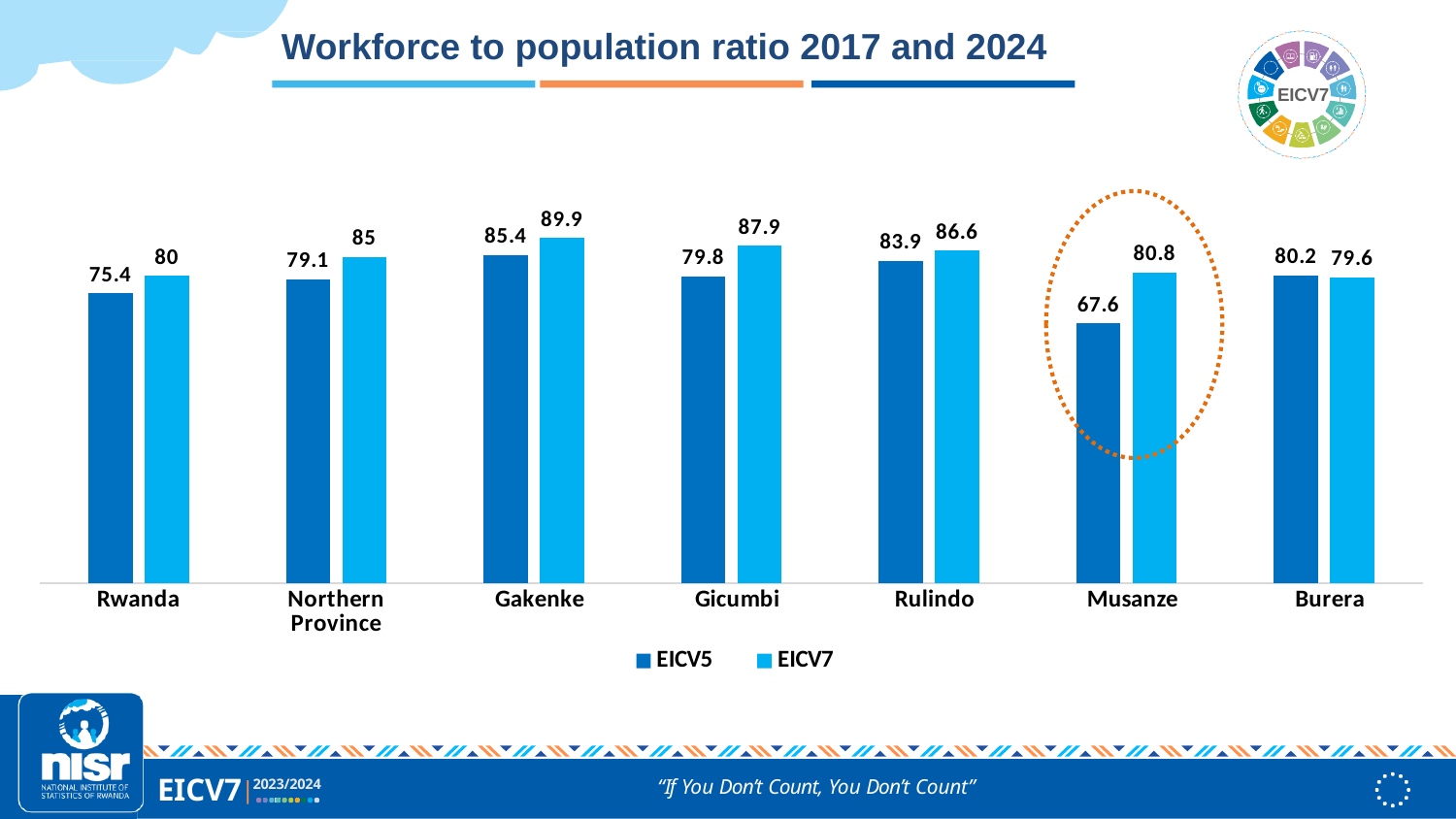
What is the difference between the EICV7 and EICV5 values for Musanze? 13.2 How many series does the legend list? 2 What is the title of the chart? Workforce to population ratio 2017 and 2024 How many categories are shown on the x axis? 7 Which category has the highest EICV7 value? Gakenke What is the EICV5 value for Musanze? 67.6 What kind of chart is shown on the slide? Bar chart Which category is highlighted with a dotted orange circle? Musanze What is the EICV7 value for Rwanda? 80 Which is larger for Burera, the EICV5 value or the EICV7 value? EICV5 What is the EICV7 workforce to population ratio for Gakenke? 89.9 Which category has the lowest EICV5 value? Musanze